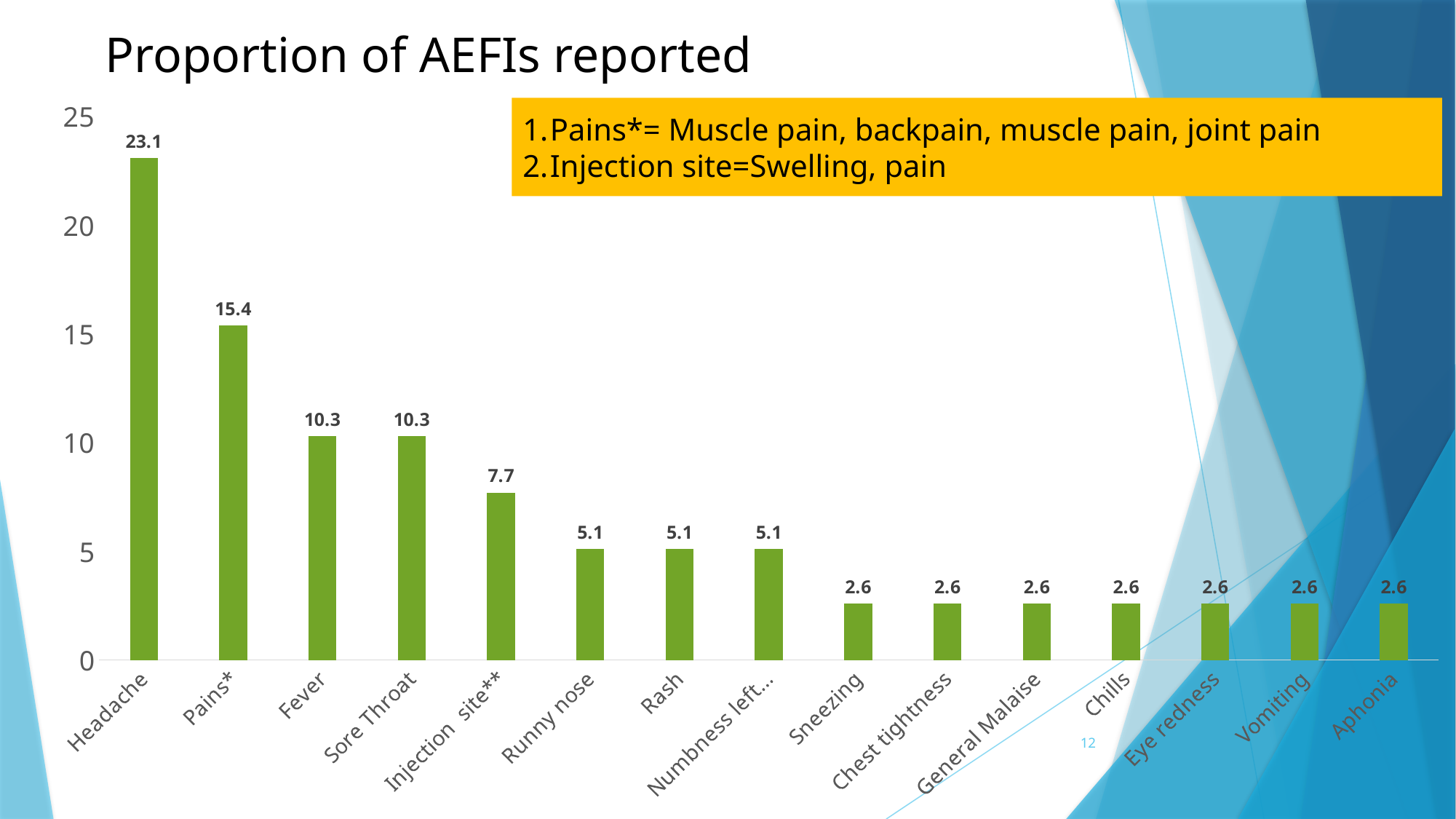
What is the difference between the values for Fever and Rash? 5.2 What is the value for Runny nose? 5.1 What is the value for Headache? 23.1 Which category has the highest value? Headache What kind of chart is shown on the slide? bar chart Is the value for Pains* greater or less than 20? less What is the value for Injection site**? 7.7 What is the value for Vomiting? 2.6 What is the difference between the values for Headache and Pains*? 7.7 Which is larger, the value for Injection site** or the value for Sneezing? Injection site** What is the value for Pains*? 15.4 How many categories are shown on the x axis? 15